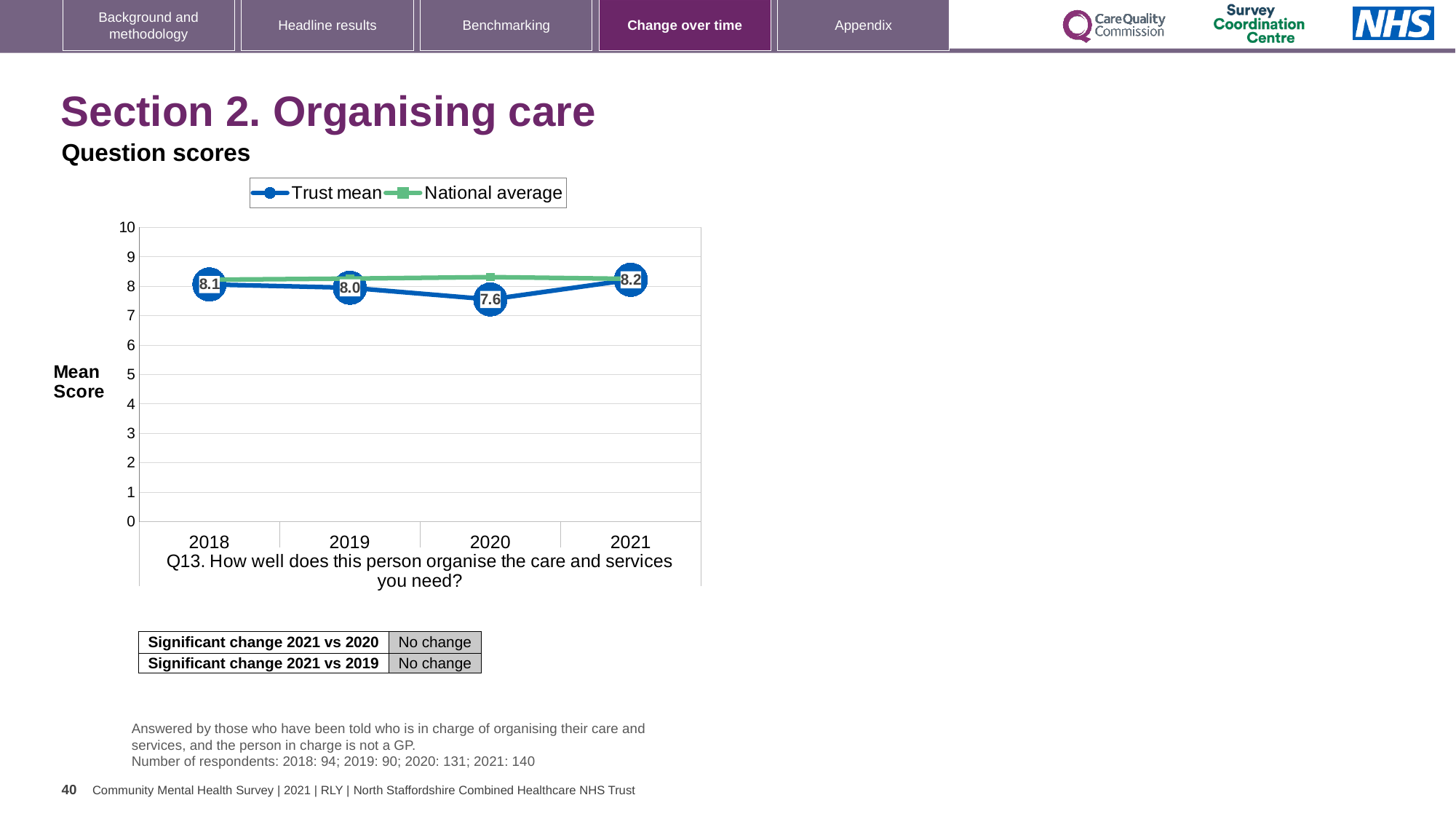
How many series does the legend list? 2 In which year is the Trust mean score lowest? 2020 What is the difference between the Trust mean scores for 2021 and 2020? 0.6 How many years are shown on the x axis of the chart? 4 Does the Trust mean score rise or fall from 2020 to 2021? rise Which is larger, the Trust mean score for 2019 or for 2020? 2019 What is the Trust mean score for 2018? 8.1 Is the National average value for 2020 greater or less than 5? greater What is the Trust mean score for 2021? 8.2 What kind of chart is shown on the slide? line chart What is the Trust mean score for 2020? 7.6 In which year is the Trust mean score highest? 2021